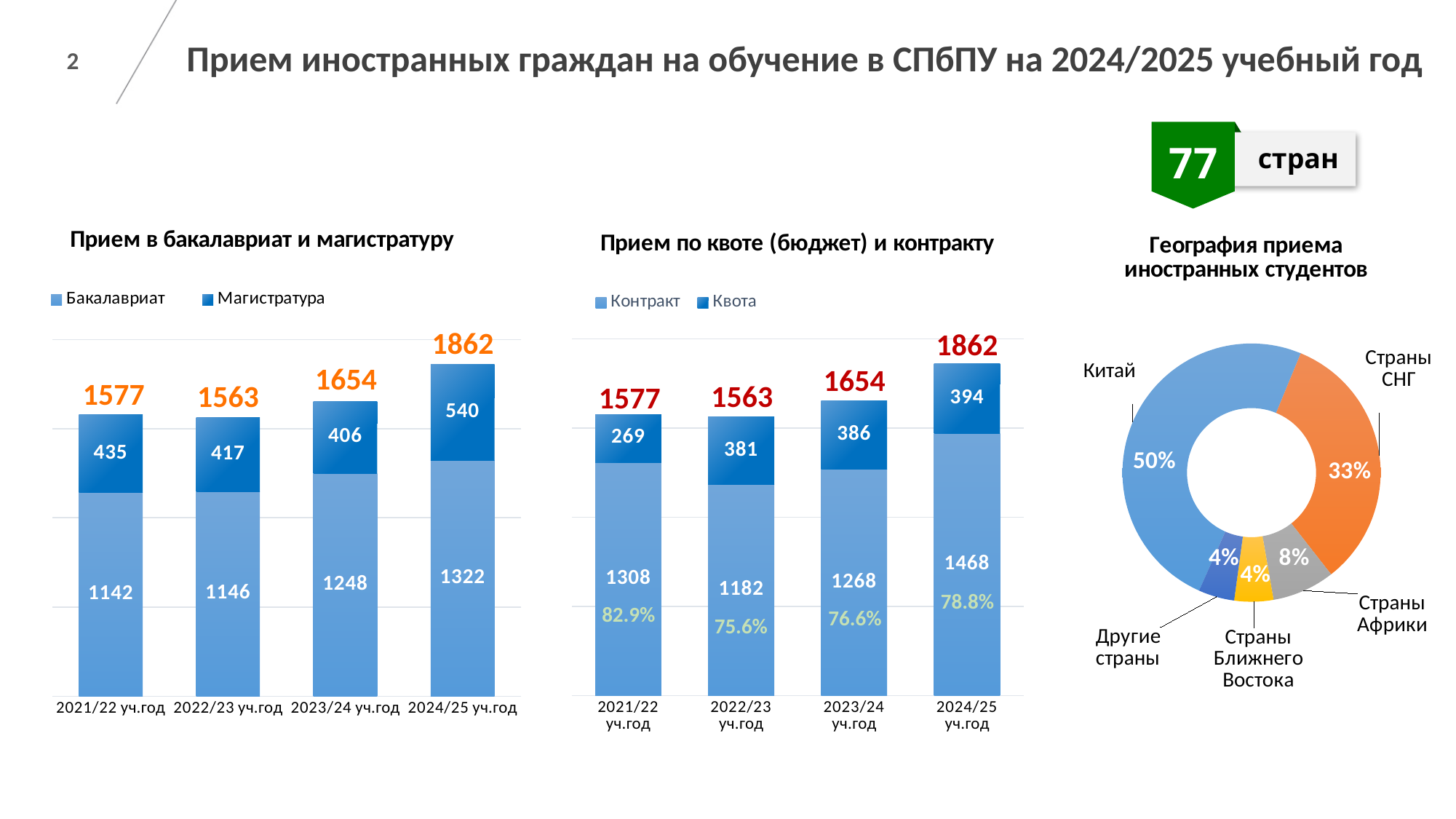
In the chart 'Прием по квоте (бюджет) и контракту', what is the value for Квота in 2022/23 уч.год? 381 In the chart 'Прием по квоте (бюджет) и контракту', what is the difference between the Контракт values for 2021/22 уч.год and 2022/23 уч.год? 126 In the chart 'Прием по квоте (бюджет) и контракту', what is the value for Контракт in 2024/25 уч.год? 1468 In the chart 'Прием в бакалавриат и магистратуру', how many series does the legend list? 2 In the chart 'Прием по квоте (бюджет) и контракту', what percentage is shown for Контракт in 2021/22 уч.год? 82.9% In the chart 'Прием в бакалавриат и магистратуру', what is the total of the stacked bar for 2023/24 уч.год? 1654 In the chart 'География приема иностранных студентов', what share does Китай have? 50% In the chart 'Прием в бакалавриат и магистратуру', which year has the lowest total? 2022/23 уч.год In the chart 'Прием в бакалавриат и магистратуру', what is the value for Магистратура in 2021/22 уч.год? 435 In the chart 'Прием по квоте (бюджет) и контракту', how many years are shown on the x axis? 4 What kind of chart is 'География приема иностранных студентов'? Donut (pie) chart In the chart 'Прием в бакалавриат и магистратуру', what is the value for Бакалавриат in 2024/25 уч.год? 1322